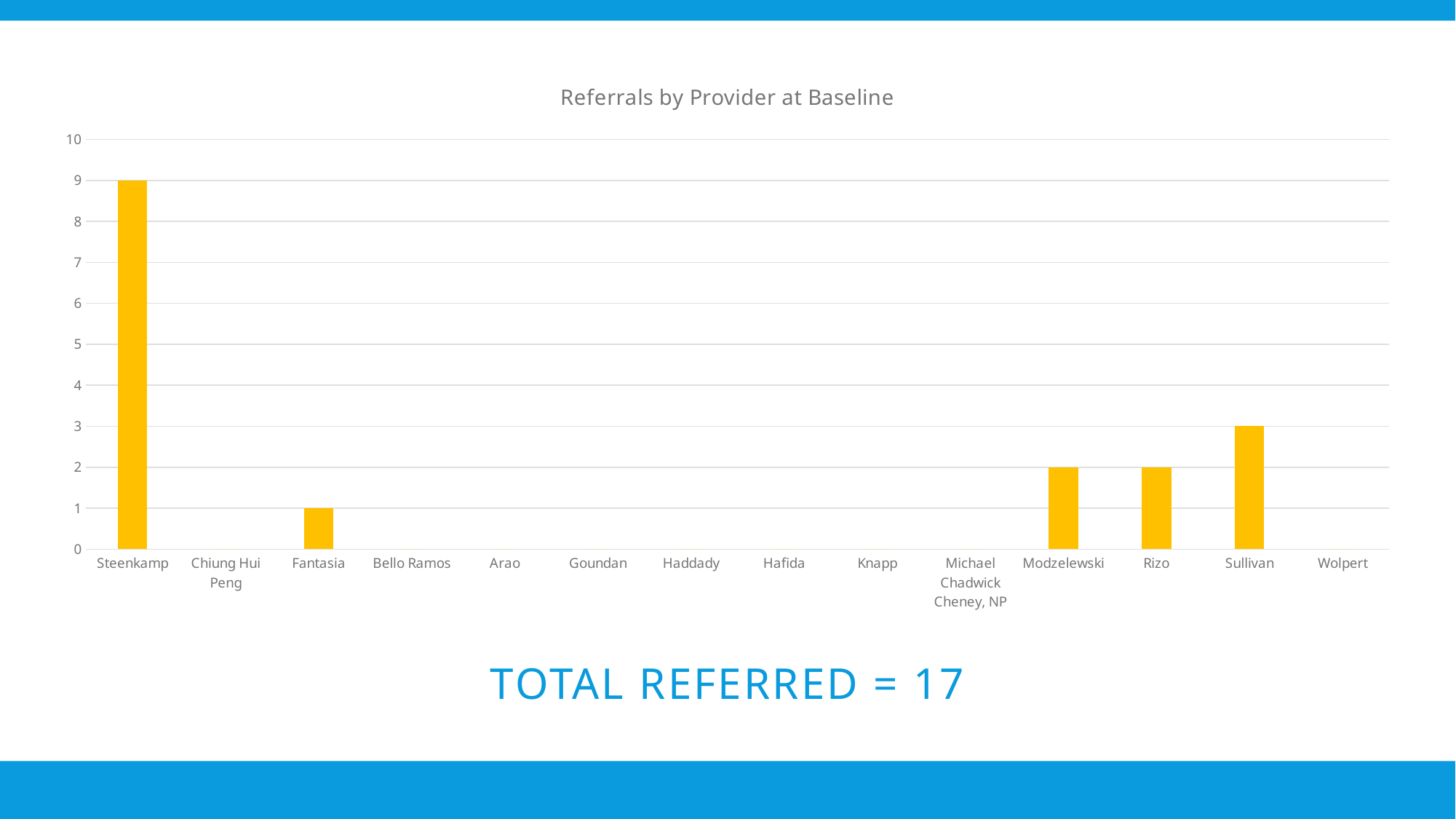
What is the difference in referrals between Steenkamp and Sullivan? 6 What is the title of the chart? Referrals by Provider at Baseline How many referrals does Fantasia have? 1 What total number of referrals is stated on the slide? 17 How many referrals does Sullivan have? 3 How many referrals does Steenkamp have? 9 How many providers are listed along the x axis of the chart? 14 Is the value for Steenkamp greater or less than 5? greater How many referrals does Modzelewski have? 2 What kind of chart is shown on the slide? bar chart Which provider has the highest number of referrals? Steenkamp Who has more referrals, Rizo or Sullivan? Sullivan